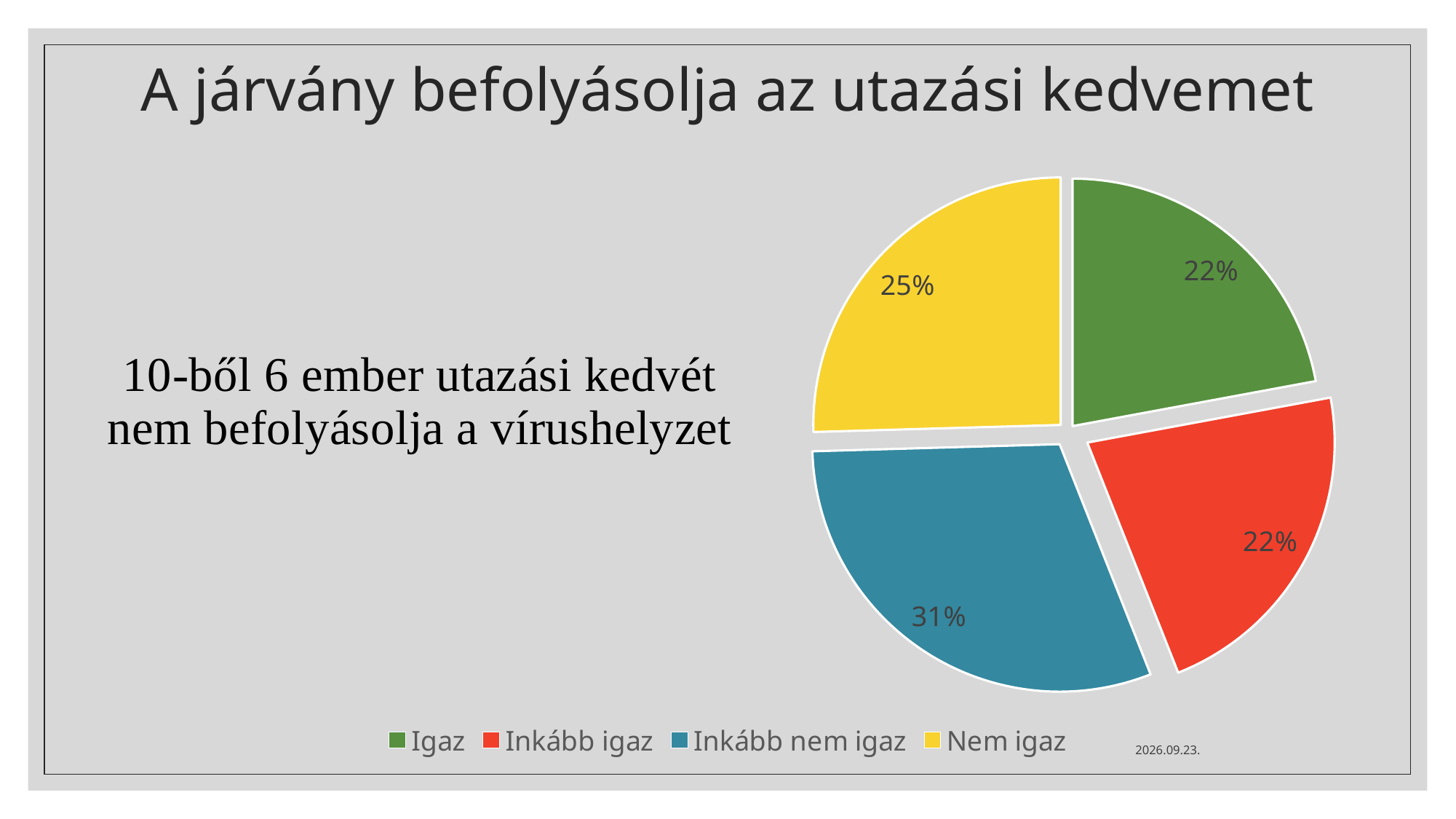
How many entries does the legend list? 4 Which category has the largest slice of the pie? Inkább nem igaz How many slices does the pie chart have? 4 What percentage is shown for the "Igaz" slice? 22% What percentage of the pie does the "Inkább nem igaz" slice represent? 31% What colour is the "Inkább igaz" slice? Red What percentage is shown for the "Nem igaz" slice? 25% What kind of chart is shown on the slide? Pie chart Which is larger, the "Nem igaz" slice or the "Igaz" slice? Nem igaz What percentage is shown for the "Inkább igaz" slice? 22% What is the difference in percentage points between the "Inkább nem igaz" slice and the "Igaz" slice? 9 percentage points What is the combined share of the "Inkább nem igaz" and "Nem igaz" slices? 56%